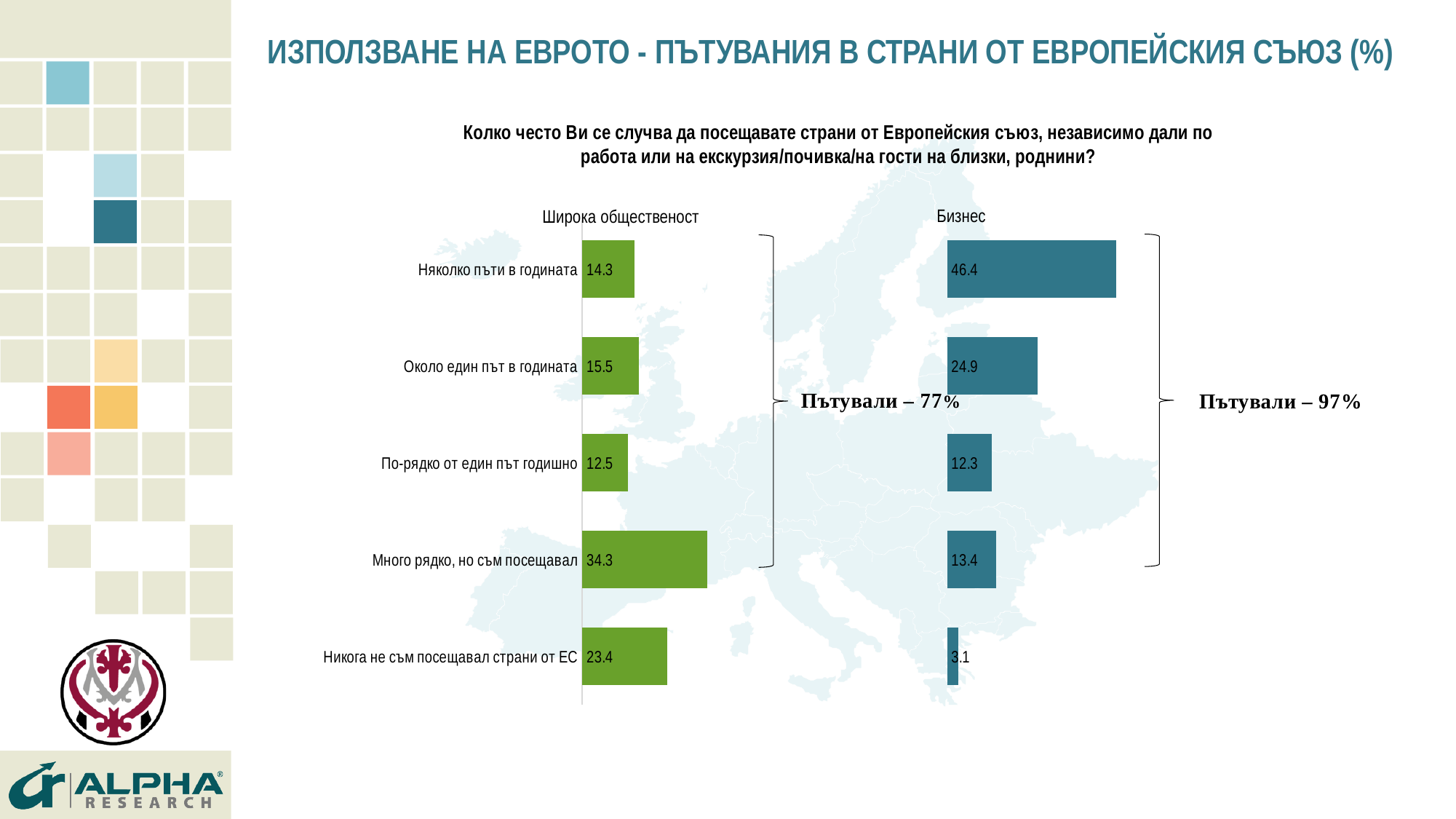
In the "Широка общественост" chart, which category has the highest value? Много рядко, но съм посещавал In the "Широка общественост" chart, which category has the lowest value? По-рядко от един път годишно How many categories are shown in the "Широка общественост" chart? 5 In the "Бизнес" chart, what is the value for "Никога не съм посещавал страни от ЕС"? 3.1 What type of chart is used on this slide? Bar chart For "Около един път в годината", which is larger: the "Широка общественост" value or the "Бизнес" value? Бизнес What is the difference between the "Бизнес" and "Широка общественост" values for "Няколко пъти в годината"? 32.1 In the "Широка общественост" chart, what is the value for "Много рядко, но съм посещавал"? 34.3 What share of respondents is labelled as "Пътували" for the "Бизнес" chart? 97% In the "Широка общественост" chart, what is the difference between "Много рядко, но съм посещавал" and "Никога не съм посещавал страни от ЕС"? 10.9 In the "Бизнес" chart, which category has the lowest value? Никога не съм посещавал страни от ЕС In the "Бизнес" chart, what is the value for "Няколко пъти в годината"? 46.4